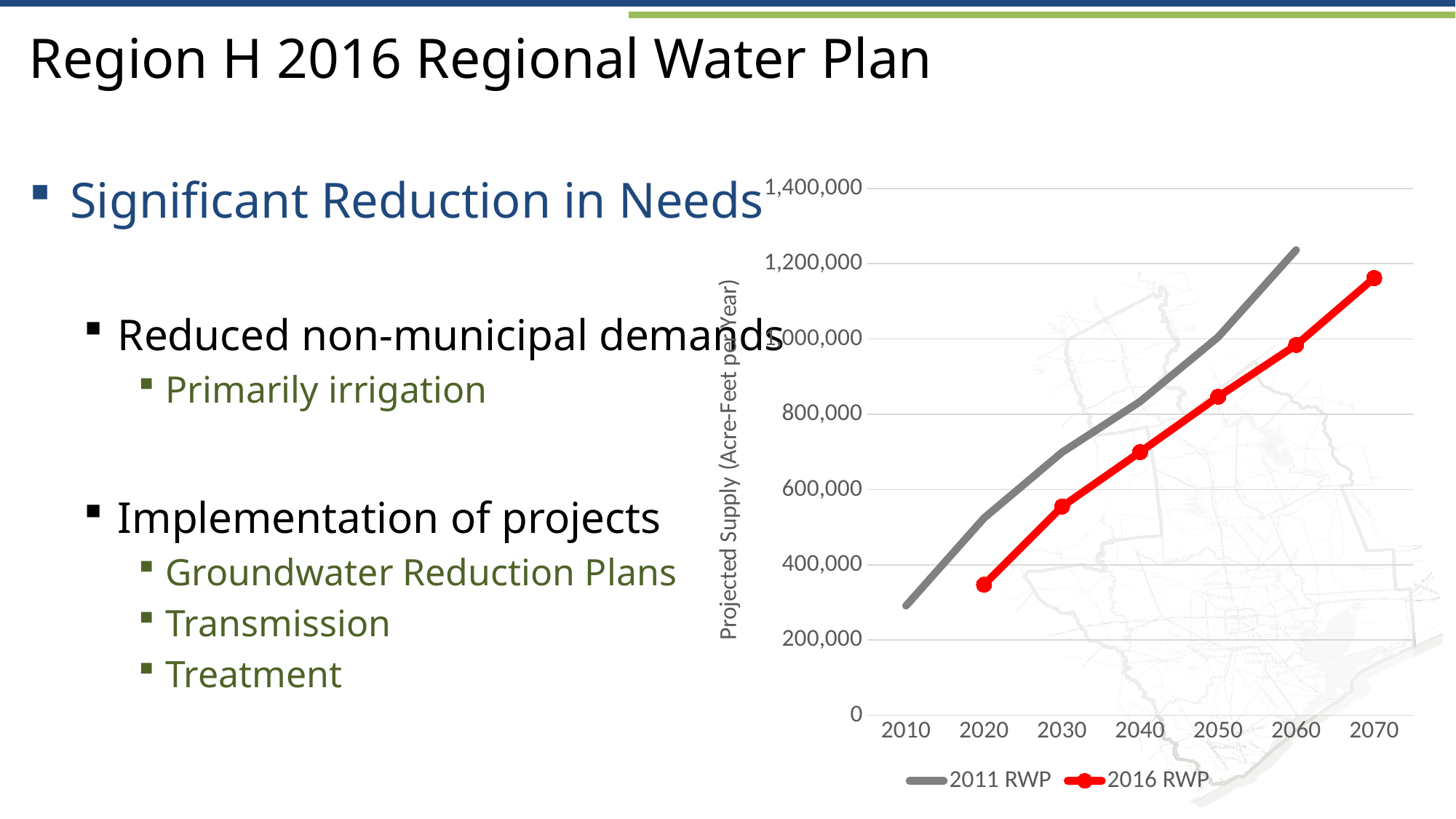
Is the 2016 RWP value for 2070 greater or less than 1,200,000? less How many data points are marked on the 2016 RWP line? 6 Is the 2011 RWP value for 2010 greater or less than 200,000? greater Is the 2011 RWP value for 2030 greater or less than 600,000? greater What colour is the 2016 RWP line in the chart? Red In 2040, which series has the higher projected supply, 2011 RWP or 2016 RWP? 2011 RWP How many series does the chart legend list? 2 What kind of chart is shown on the slide? Line chart How many years are labelled on the x axis of the chart? 7 What is the label on the y axis of the chart? Projected Supply (Acre-Feet per Year) Do the values of the 2016 RWP series rise or fall from 2020 to 2070? Rise